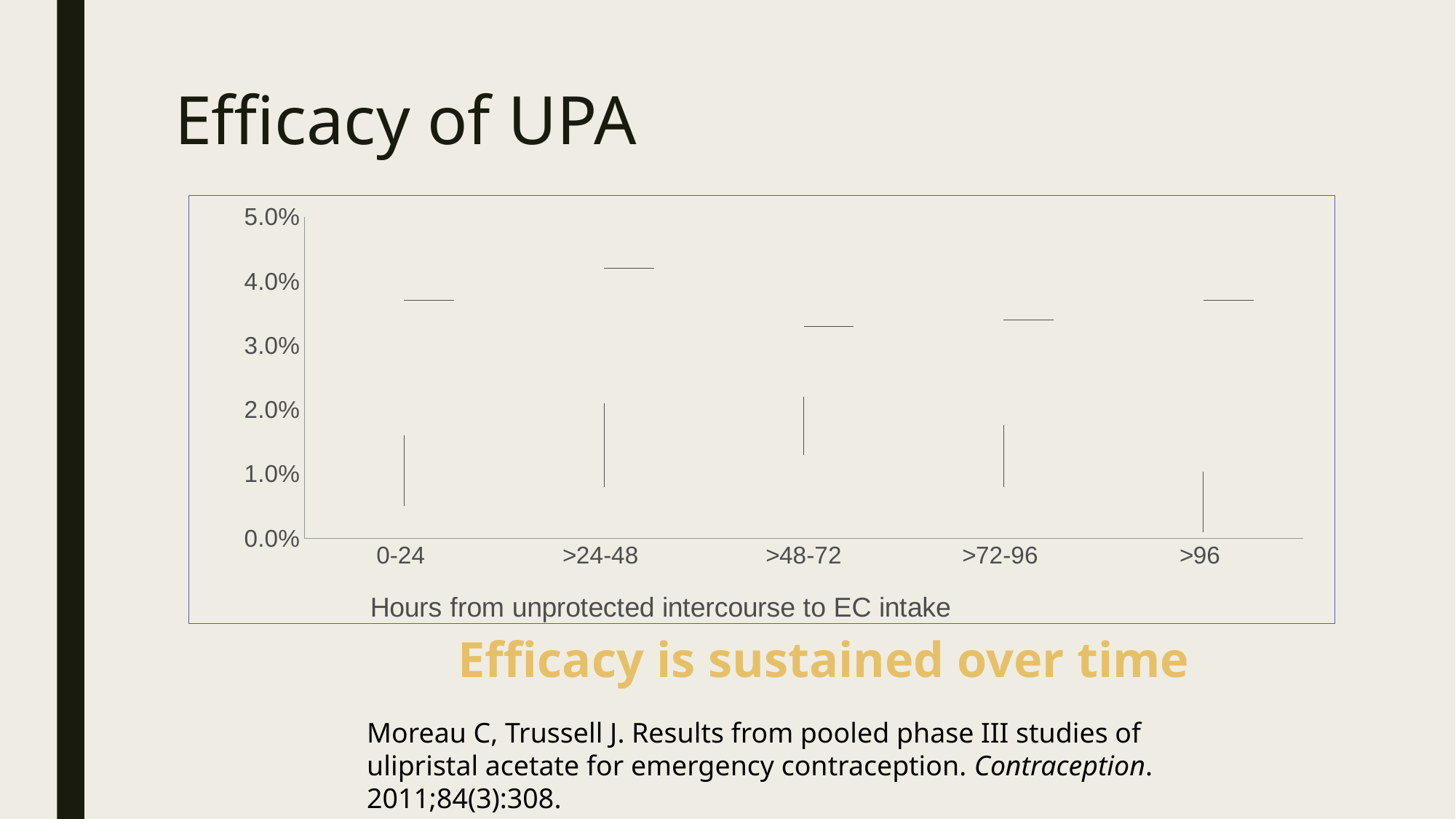
Which has the higher horizontal marker, 0-24 or >48-72? 0-24 Is the horizontal marker for the >72-96 category greater or less than 3.0%? greater What is the first category label on the x axis of the chart? 0-24 What is the x-axis title of the chart? Hours from unprotected intercourse to EC intake What is the highest value shown on the y axis of the chart? 5.0% Which has the higher horizontal marker, >24-48 or >48-72? >24-48 Is the horizontal marker for the >48-72 category greater or less than 4.0%? less Is the horizontal marker for the >96 category greater or less than 4.0%? less How many categories are shown on the x axis of the chart? 5 Which category has the highest horizontal marker on the chart? >24-48